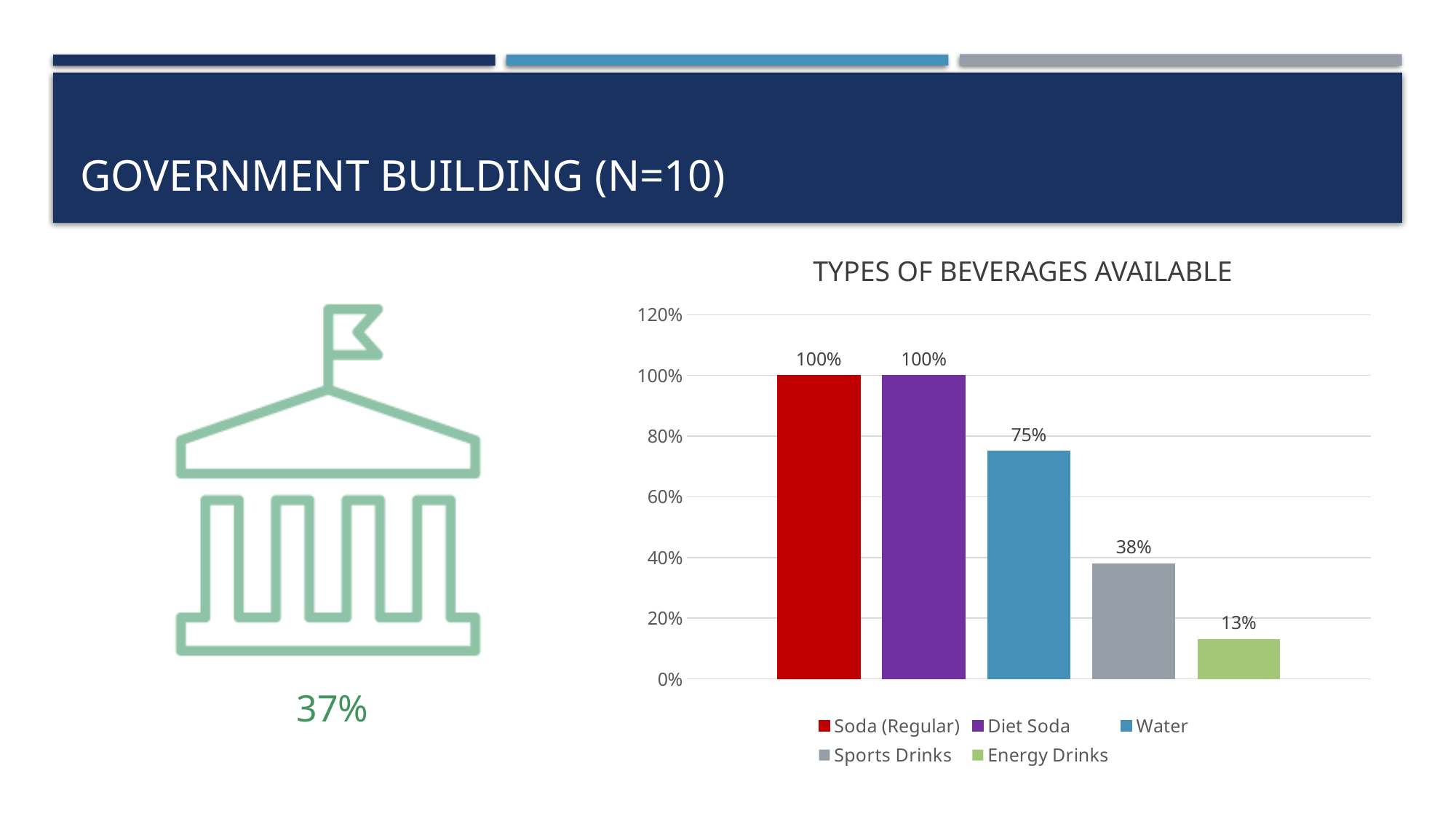
How many beverage types are shown in the chart? 5 What is the value for Sports Drinks? 38% Is the value for Sports Drinks greater or less than 40%? less What is the value for Water in the Types of Beverages Available chart? 75% What is the difference between the values for Water and Sports Drinks? 37% What is the value for Energy Drinks? 13% Which beverage type has the lowest value? Energy Drinks What is the title of the chart? Types of Beverages Available Which is larger, the value for Water or the value for Sports Drinks? Water What is the difference between the values for Soda (Regular) and Energy Drinks? 87% What kind of chart is shown on the slide? bar chart What is the value for Diet Soda? 100%